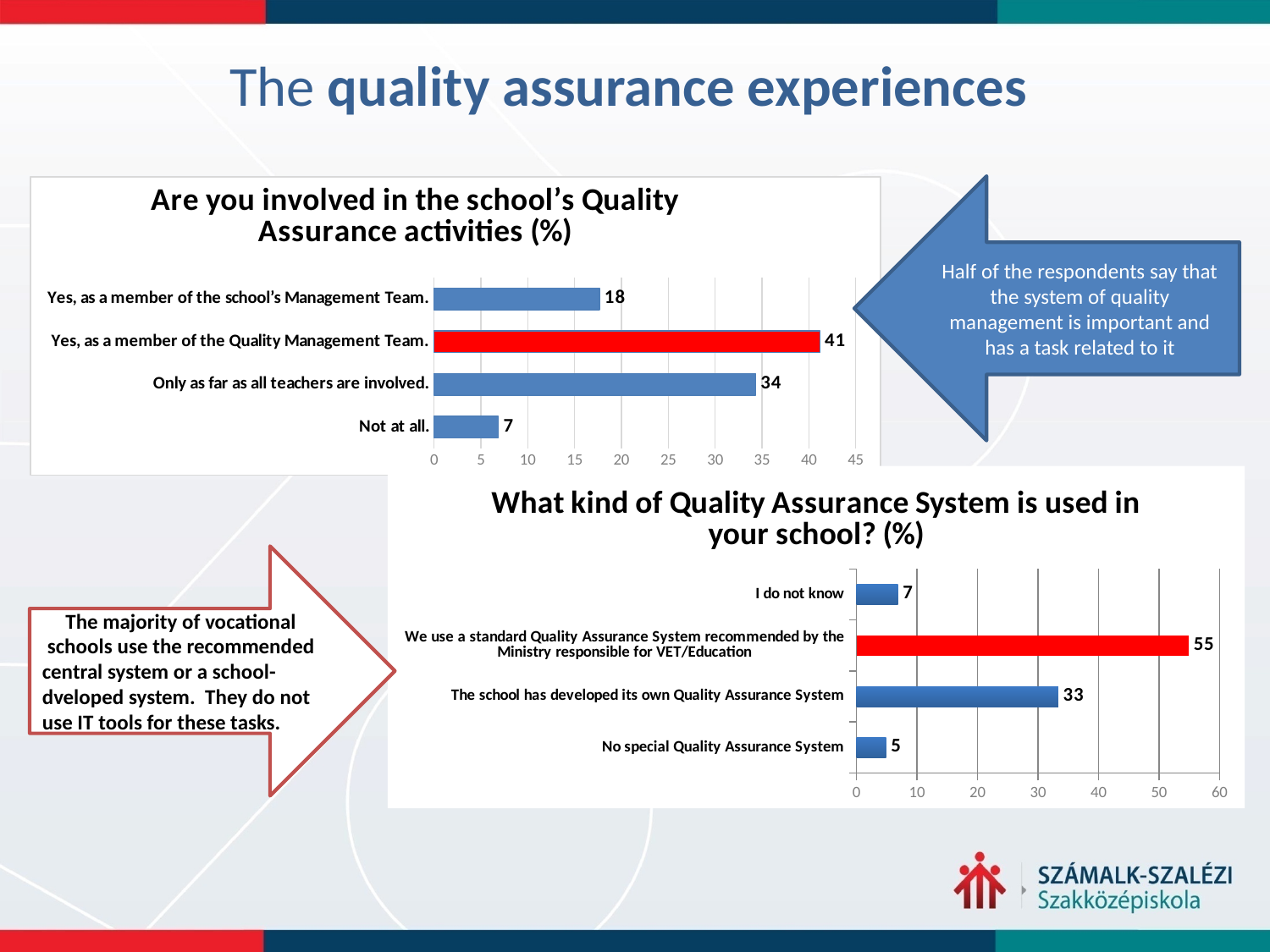
In the chart titled "What kind of Quality Assurance System is used in your school? (%)", which category has the highest value? We use a standard Quality Assurance System recommended by the Ministry responsible for VET/Education In the chart titled "What kind of Quality Assurance System is used in your school? (%)", what is the value for "The school has developed its own Quality Assurance System"? 33 In the chart titled "Are you involved in the school's Quality Assurance activities (%)", what is the value for "Yes, as a member of the Quality Management Team."? 41 What kind of chart is the chart titled "What kind of Quality Assurance System is used in your school? (%)"? Bar chart In the chart titled "Are you involved in the school's Quality Assurance activities (%)", what colour is the bar for "Yes, as a member of the Quality Management Team."? Red In the chart titled "Are you involved in the school's Quality Assurance activities (%)", what is the difference between the values for "Yes, as a member of the Quality Management Team." and "Only as far as all teachers are involved."? 7 In the chart titled "What kind of Quality Assurance System is used in your school? (%)", what is the highest value shown on the x axis? 60 In the chart titled "What kind of Quality Assurance System is used in your school? (%)", which is larger: the value for "I do not know" or the value for "No special Quality Assurance System"? I do not know In the chart titled "What kind of Quality Assurance System is used in your school? (%)", what is the difference between the values for the standard Ministry-recommended system and the school's own system? 22 In the chart titled "Are you involved in the school's Quality Assurance activities (%)", what is the value for "Yes, as a member of the school's Management Team."? 18 In the chart titled "Are you involved in the school's Quality Assurance activities (%)", which category has the lowest value? Not at all. In the chart titled "Are you involved in the school's Quality Assurance activities (%)", how many categories are shown? 4